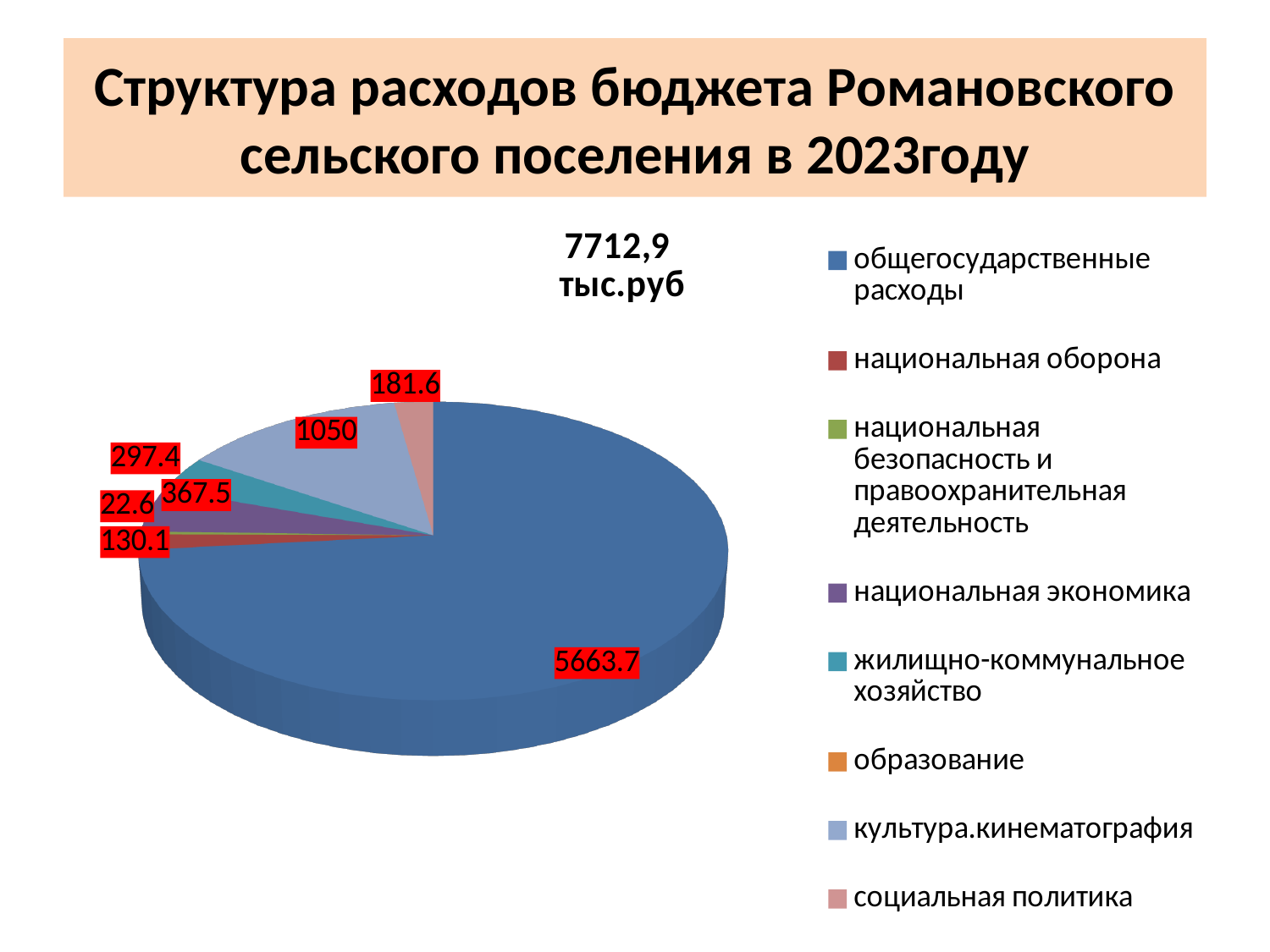
What total amount is shown in the chart's title? 7712,9 тыс.руб What is the value for национальная экономика? 367.5 How many categories does the legend list? 8 Which category has the largest slice of the pie? общегосударственные расходы What is the value for культура.кинематография? 1050 What is the value for жилищно-коммунальное хозяйство? 297.4 Which is larger, национальная экономика or жилищно-коммунальное хозяйство? национальная экономика What is the value for социальная политика? 181.6 What is the value for общегосударственные расходы? 5663.7 What kind of chart is shown on the slide? pie chart What is the difference between the values for культура.кинематография and социальная политика? 868.4 What is the value for национальная оборона? 130.1